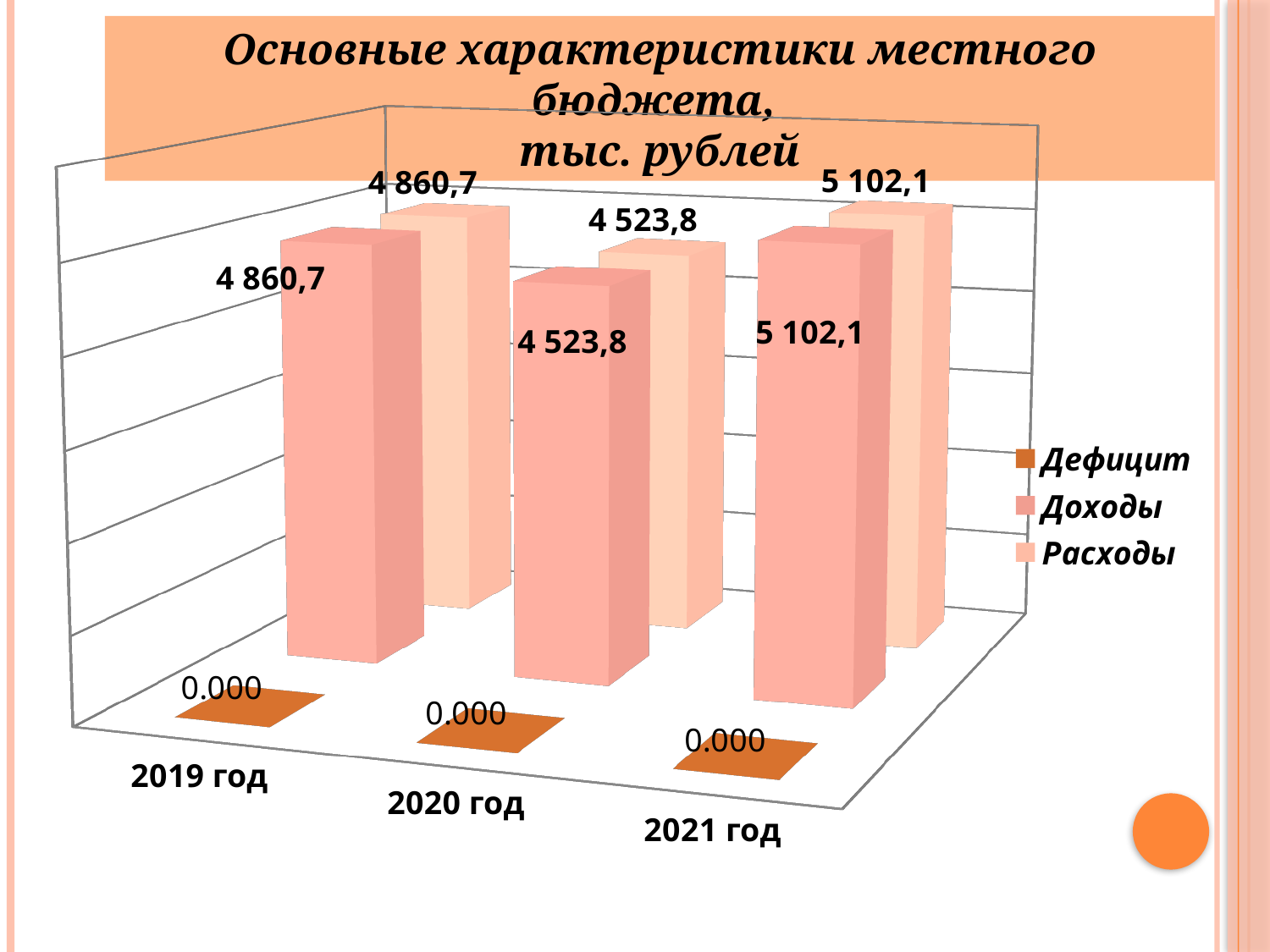
What is the value of Доходы for 2019 год? 4 860,7 In which year is Доходы the highest? 2021 год What is the value of Расходы for 2021 год? 5 102,1 What is the difference between Доходы in 2021 год and Доходы in 2020 год? 578,3 What is the value of Доходы for 2020 год? 4 523,8 What is the value of Дефицит for 2020 год? 0.000 What is the title of the chart? Основные характеристики местного бюджета, тыс. рублей What kind of chart is shown on the slide? bar chart In which year is Расходы the lowest? 2020 год How many series does the legend list? 3 How many years are shown on the x axis? 3 Which is larger: Доходы in 2019 год or Доходы in 2020 год? 2019 год